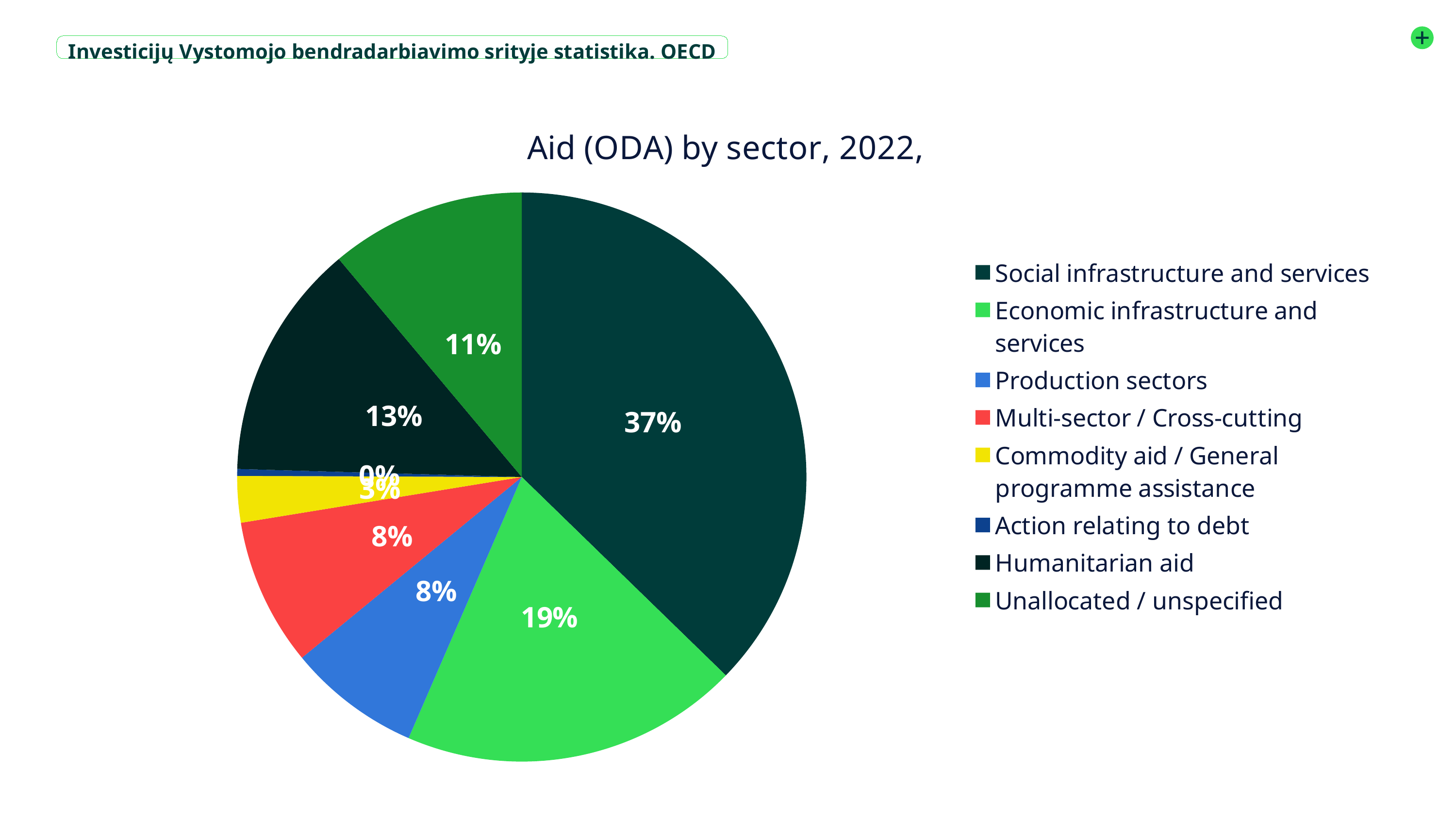
What share of aid goes to Economic infrastructure and services? 19% What type of chart is shown on the slide? pie chart What share of aid is Unallocated / unspecified? 11% Which has a larger share, Humanitarian aid or Unallocated / unspecified? Humanitarian aid Which sector has the smallest share of the pie? Action relating to debt What is the difference between the shares of Social infrastructure and services and Economic infrastructure and services? 18% What is the title of the chart? Aid (ODA) by sector, 2022, What share of aid goes to Social infrastructure and services? 37% What share of aid goes to Production sectors? 8% Which sector has the largest share of the pie? Social infrastructure and services How many sectors does the legend list? 8 What share of aid goes to Humanitarian aid? 13%